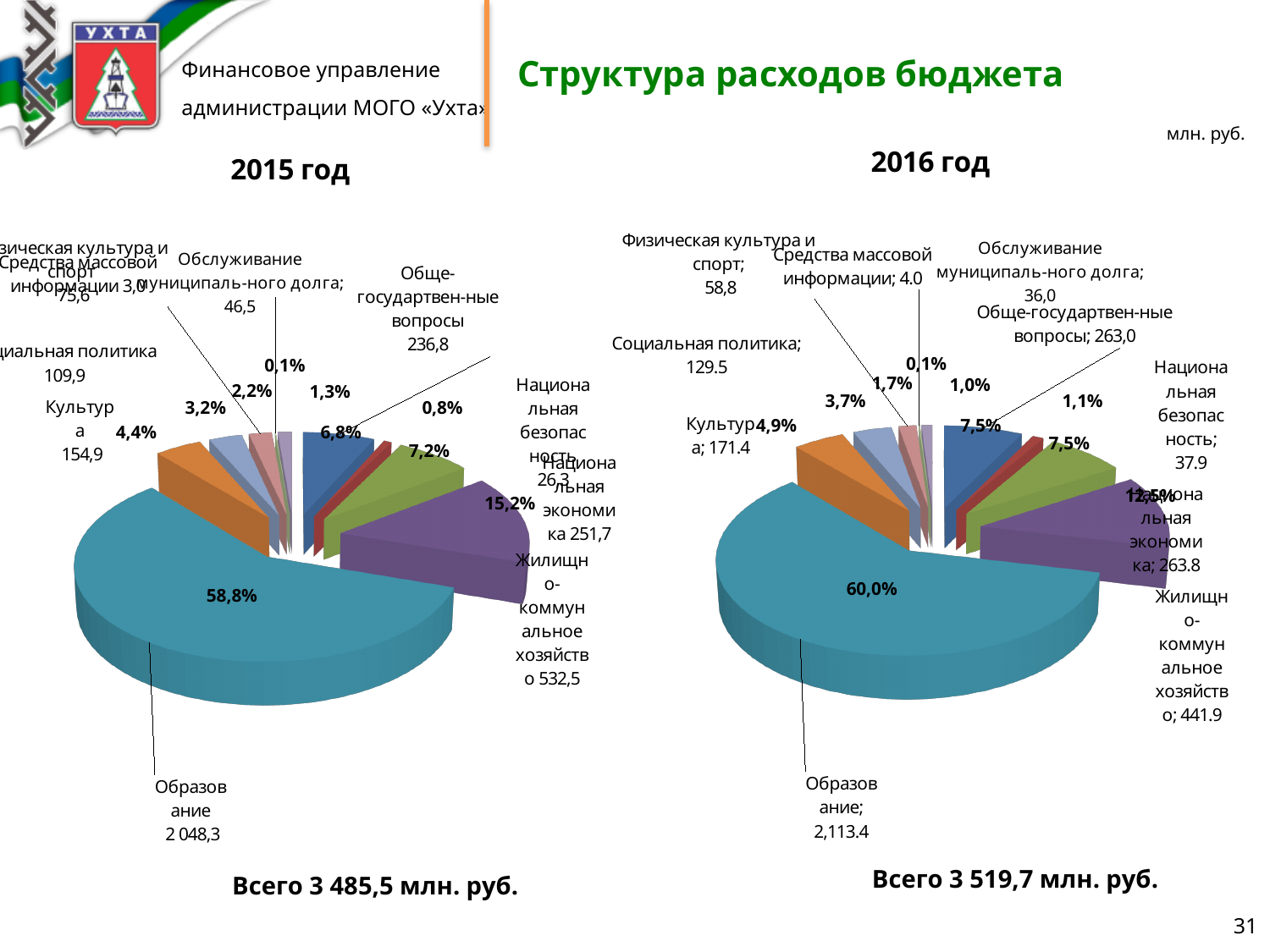
In the 2015 год chart, what is the value for Жилищно-коммунальное хозяйство? 532,5 In the 2016 год chart, what is the value for Образование? 2,113.4 In the 2016 год chart, what is the value for Национальная экономика? 263.8 In the 2016 год chart, what share of the pie does Образование take? 60,0% In the 2016 год chart, which category has the largest slice? Образование In the 2015 год chart, what is the difference between Образование (2 048,3) and Жилищно-коммунальное хозяйство (532,5)? 1 515,8 In the 2015 год chart, what share of the pie does Жилищно-коммунальное хозяйство take? 15,2% What type of chart is used for the 2015 год chart? pie chart How many categories are shown in the 2016 год chart? 10 In the 2016 год chart, which is larger: Культура or Социальная политика? Культура What total is stated below the 2016 год chart? Всего 3 519,7 млн. руб. In the 2015 год chart, which category has the smallest slice? Средства массовой информации